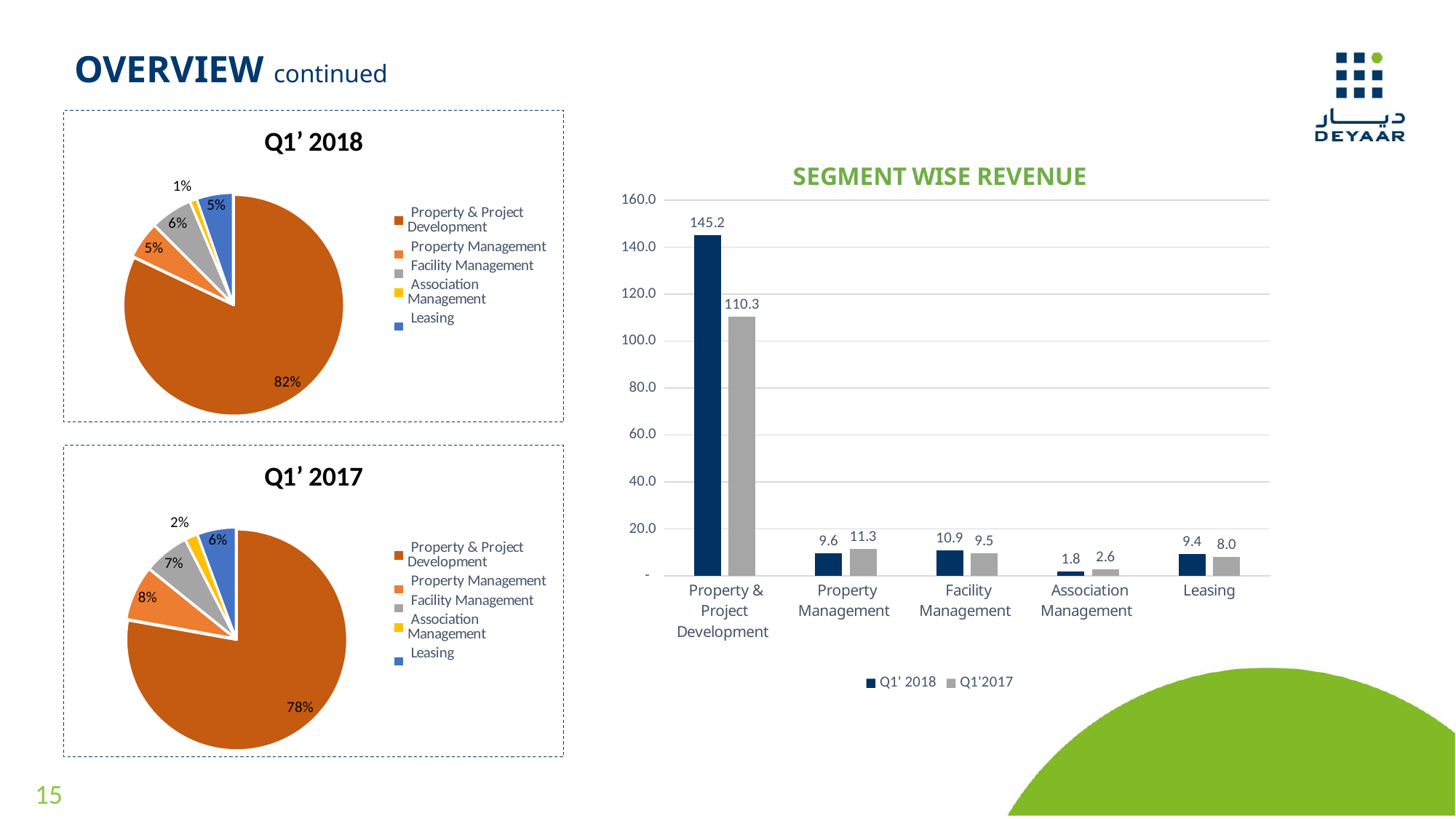
In the Segment Wise Revenue bar chart, what is the Q1' 2018 value for Property & Project Development? 145.2 In the Segment Wise Revenue bar chart, what is the Q1'2017 value for Association Management? 2.6 In the Q1' 2017 pie chart, which segment has the smallest share? Association Management In the Q1' 2018 pie chart, what share does Property & Project Development have? 82% In the Q1' 2017 pie chart, what share does Property Management have? 8% In the Segment Wise Revenue bar chart, how many segment categories are shown on the x axis? 5 What kind of chart is the Segment Wise Revenue chart? bar chart In the Segment Wise Revenue bar chart, how many series does the legend list? 2 In the Segment Wise Revenue bar chart, what is the difference between the Q1' 2018 and Q1'2017 values for Property & Project Development? 34.9 In the Segment Wise Revenue bar chart, which segment has the highest Q1' 2018 revenue? Property & Project Development In the Segment Wise Revenue bar chart, is the Q1' 2018 value for Leasing larger or smaller than the Q1'2017 value for Leasing? larger In the Segment Wise Revenue bar chart, which segment has the lowest Q1'2017 revenue? Association Management